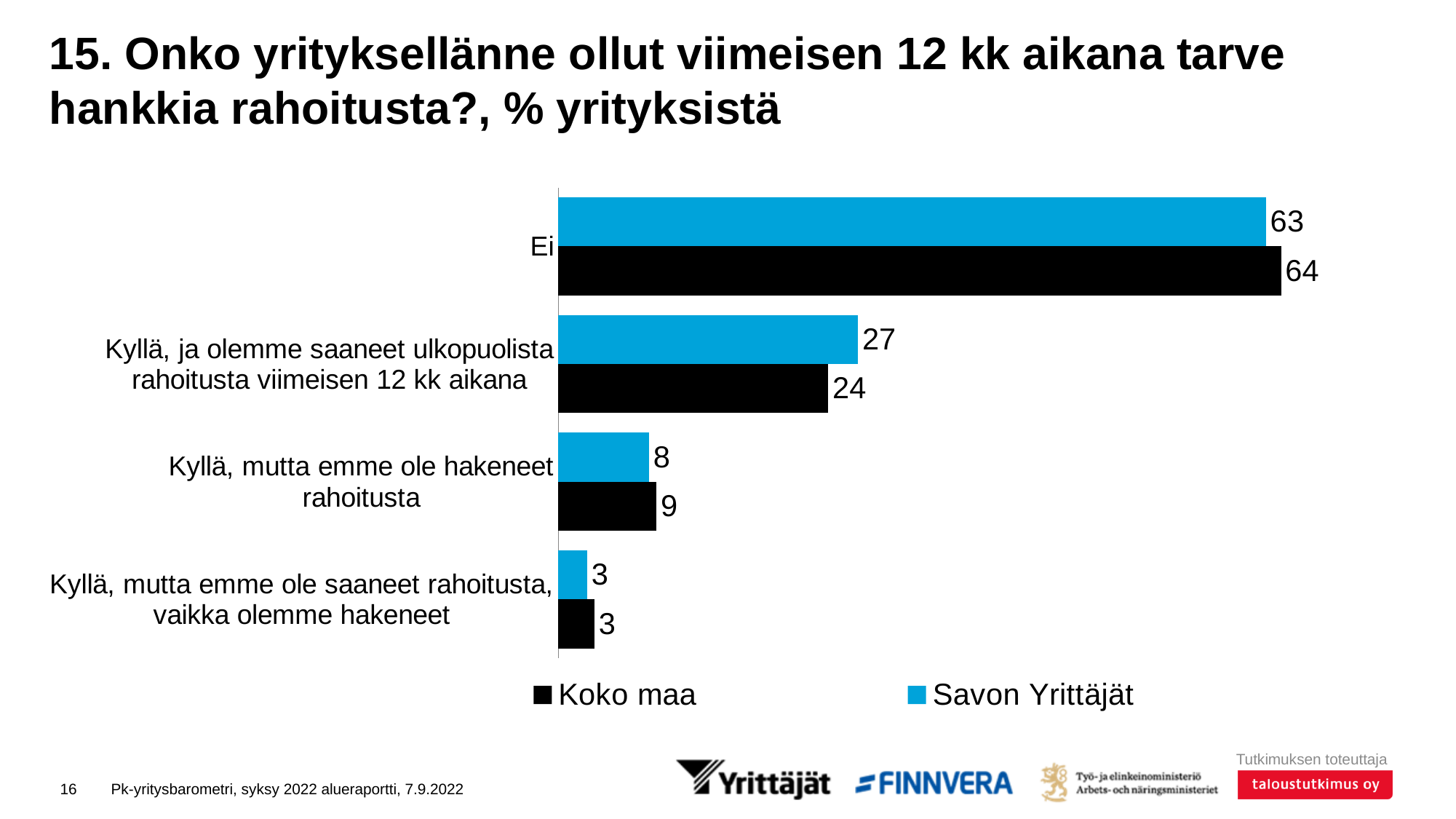
What kind of chart is shown on the slide? Bar chart In the "Ei" category, which series has the larger value, Koko maa or Savon Yrittäjät? Koko maa What is the value for Koko maa in the "Kyllä, mutta emme ole hakeneet rahoitusta" category? 9 What is the value for Koko maa in the "Kyllä, ja olemme saaneet ulkopuolista rahoitusta viimeisen 12 kk aikana" category? 24 What is the value for Savon Yrittäjät in the "Ei" category? 63 Which colour represents Savon Yrittäjät in the chart? Blue What is the value for Savon Yrittäjät in the "Kyllä, mutta emme ole saaneet rahoitusta, vaikka olemme hakeneet" category? 3 What is the difference between Savon Yrittäjät and Koko maa in the "Kyllä, ja olemme saaneet ulkopuolista rahoitusta viimeisen 12 kk aikana" category? 3 Which category has the highest value for Koko maa? Ei How many categories are shown in the chart? 4 How many series does the legend list? 2 Which category has the lowest value for Savon Yrittäjät? Kyllä, mutta emme ole saaneet rahoitusta, vaikka olemme hakeneet